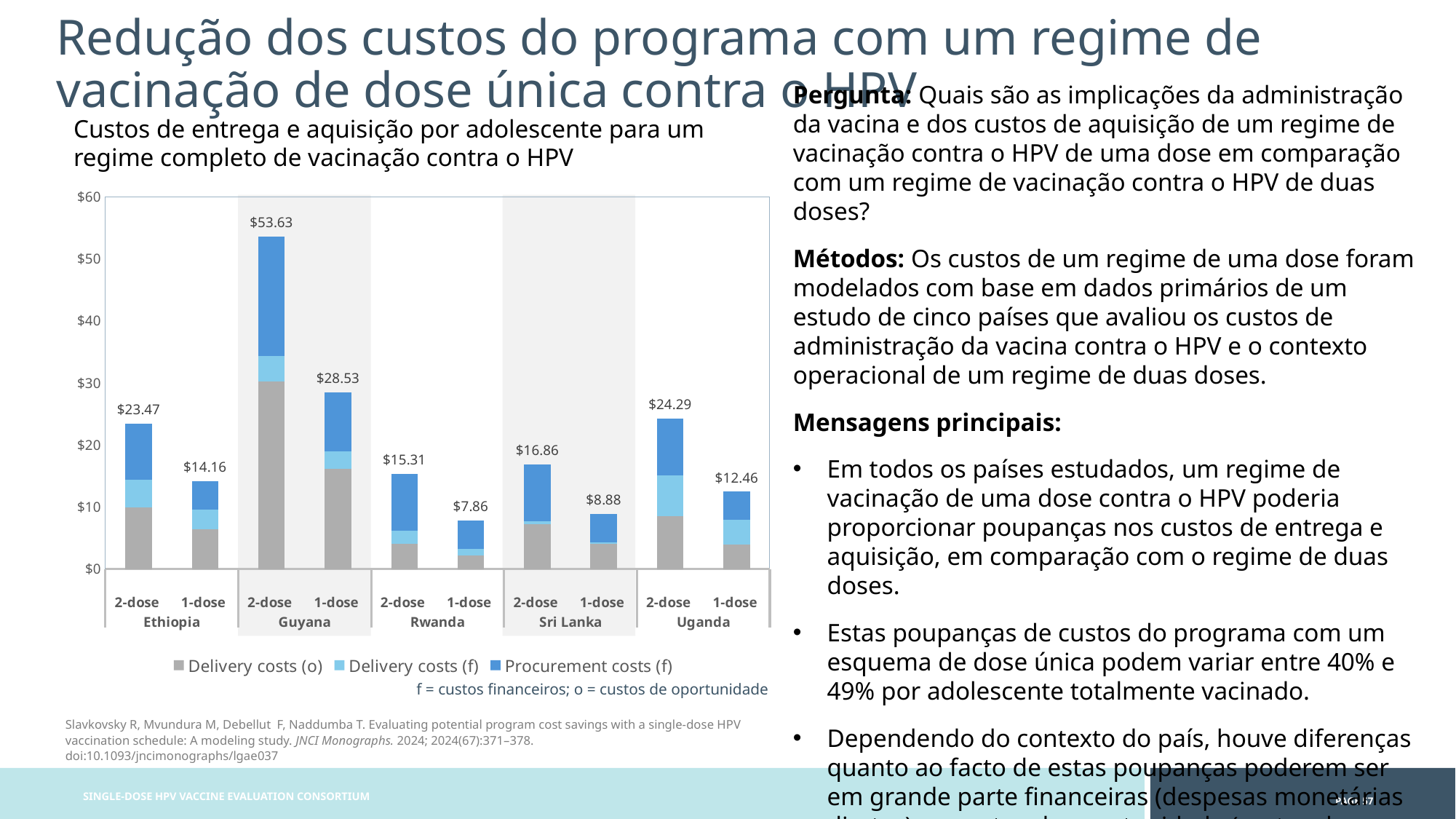
Which is larger, the 2-dose total for Uganda or the 2-dose total for Ethiopia? Uganda 2-dose How many series does the legend list? 3 What is the difference between the 2-dose and 1-dose totals for Ethiopia? $9.31 How many bars are plotted in the chart? 10 What kind of chart is shown on the slide? Stacked bar chart What is the total cost per adolescent for the 1-dose regimen in Uganda? $12.46 What is the total cost per adolescent for the 2-dose regimen in Guyana? $53.63 What is the difference between the 2-dose and 1-dose totals for Guyana? $25.10 Which bar has the highest total cost? Guyana 2-dose Which series is shown in gray in the legend? Delivery costs (o) Which bar has the lowest total cost? Rwanda 1-dose What is the total cost per adolescent for the 1-dose regimen in Rwanda? $7.86